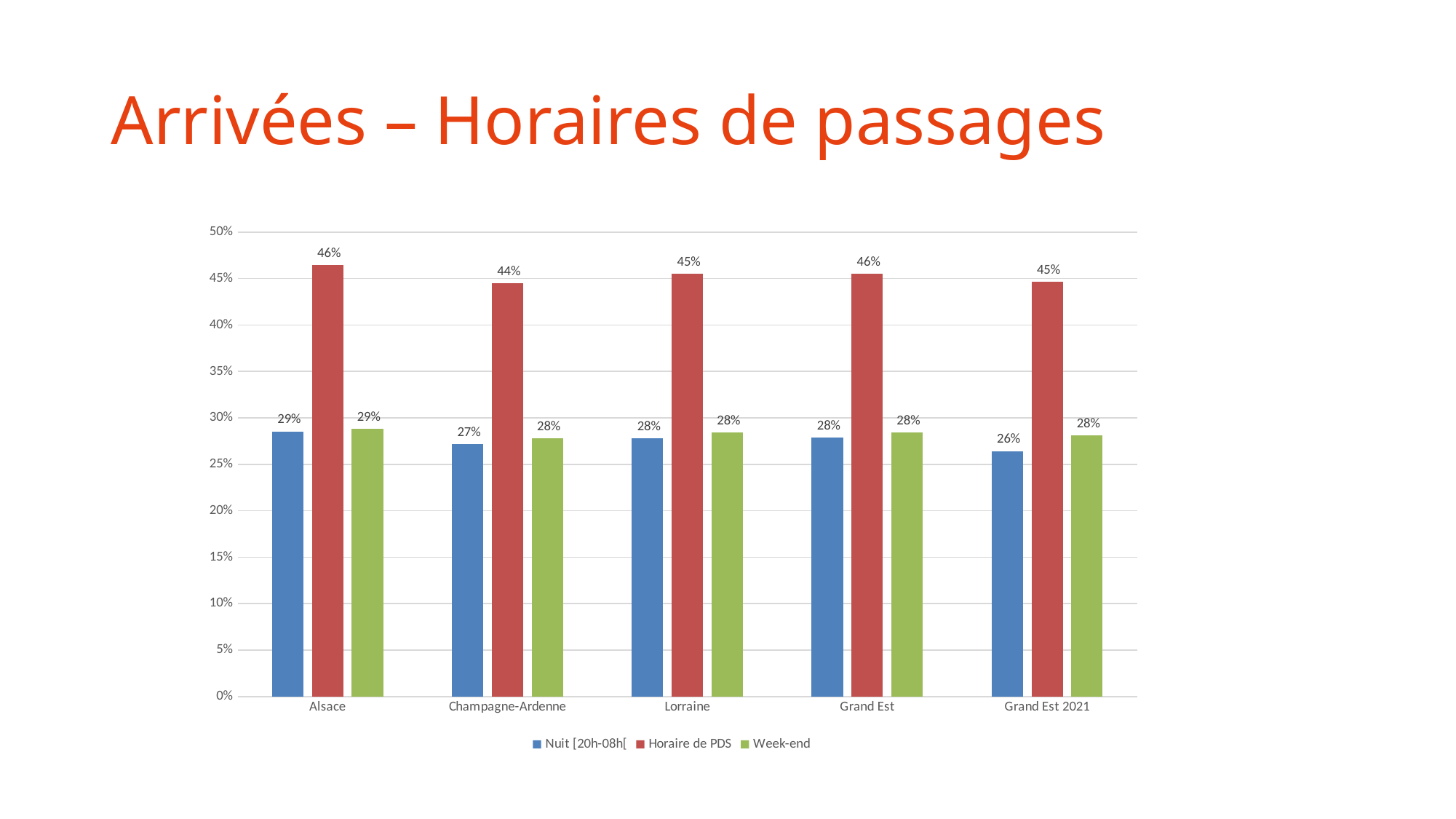
How many categories are shown on the x axis? 5 What kind of chart is shown on the slide? Bar chart How many series does the legend list? 3 Is the Nuit [20h-08h[ value for Grand Est 2021 greater or less than 30%? less What is the title of the slide? Arrivées – Horaires de passages Which is larger in Lorraine: the Horaire de PDS value or the Week-end value? Horaire de PDS What is the Week-end value for Grand Est 2021? 28% What is the value for Nuit [20h-08h[ in Champagne-Ardenne? 27% Which category has the lowest value for Horaire de PDS? Champagne-Ardenne Which category has the lowest value for Nuit [20h-08h[? Grand Est 2021 What is the value for Horaire de PDS in Alsace? 46% What is the difference between the Horaire de PDS value and the Nuit [20h-08h[ value for Alsace? 17%